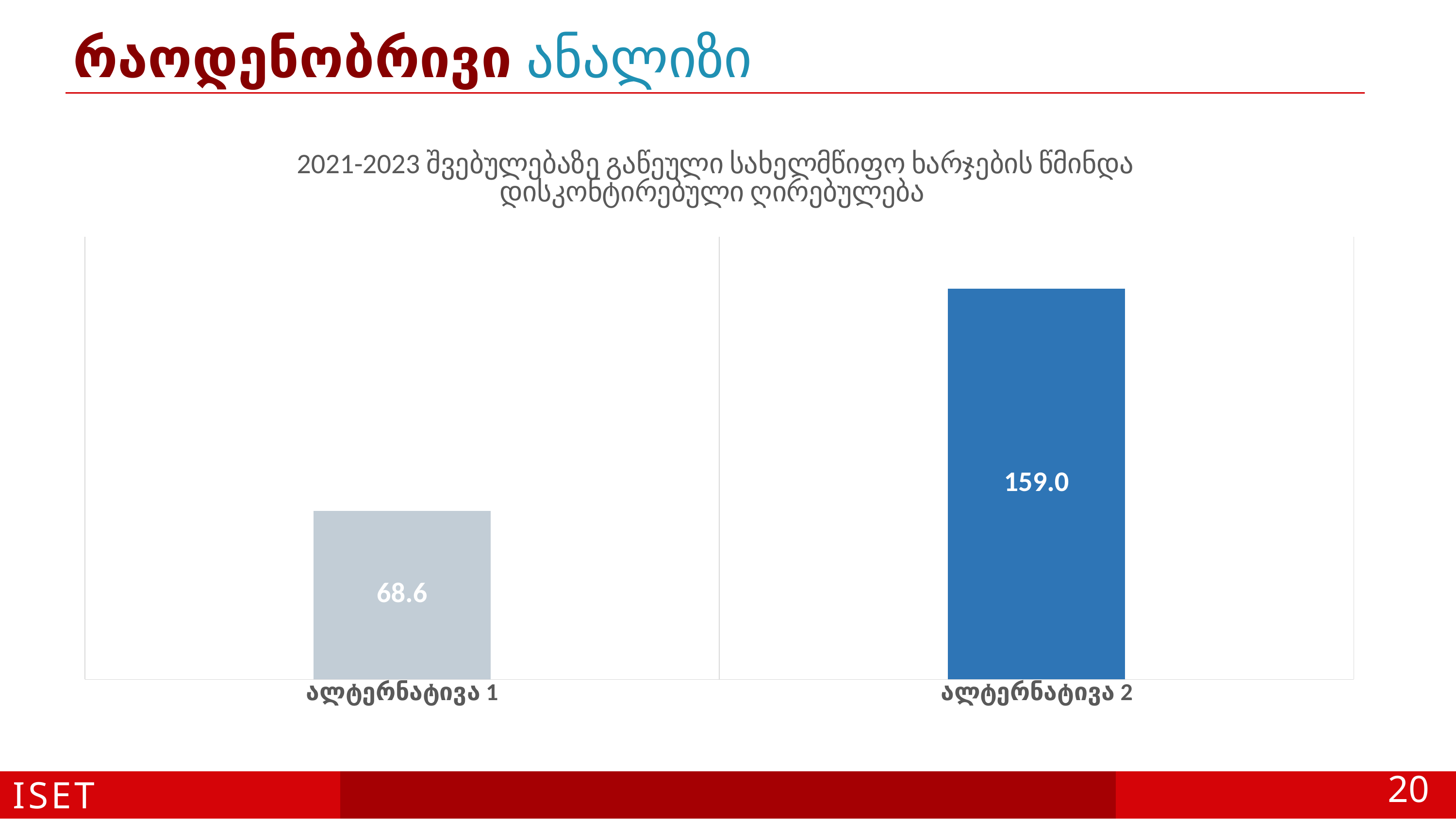
What colour is the bar for ალტერნატივა 2? Blue Which category has the lowest value? ალტერნატივა 1 What kind of chart is shown on the slide? Bar chart Which is larger, the value for ალტერნატივა 1 or the value for ალტერნატივა 2? ალტერნატივა 2 What is the value for ალტერნატივა 1? 68.6 What is the title of the chart? 2021-2023 შვებულებაზე გაწეული სახელმწიფო ხარჯების წმინდა დისკონტირებული ღირებულება How many categories are shown in the chart? 2 What is the difference between the values for ალტერნატივა 2 and ალტერნატივა 1? 90.4 Do the values rise or fall from ალტერნატივა 1 to ალტერნატივა 2? Rise What is the value for ალტერნატივა 2? 159.0 Which category has the highest value? ალტერნატივა 2